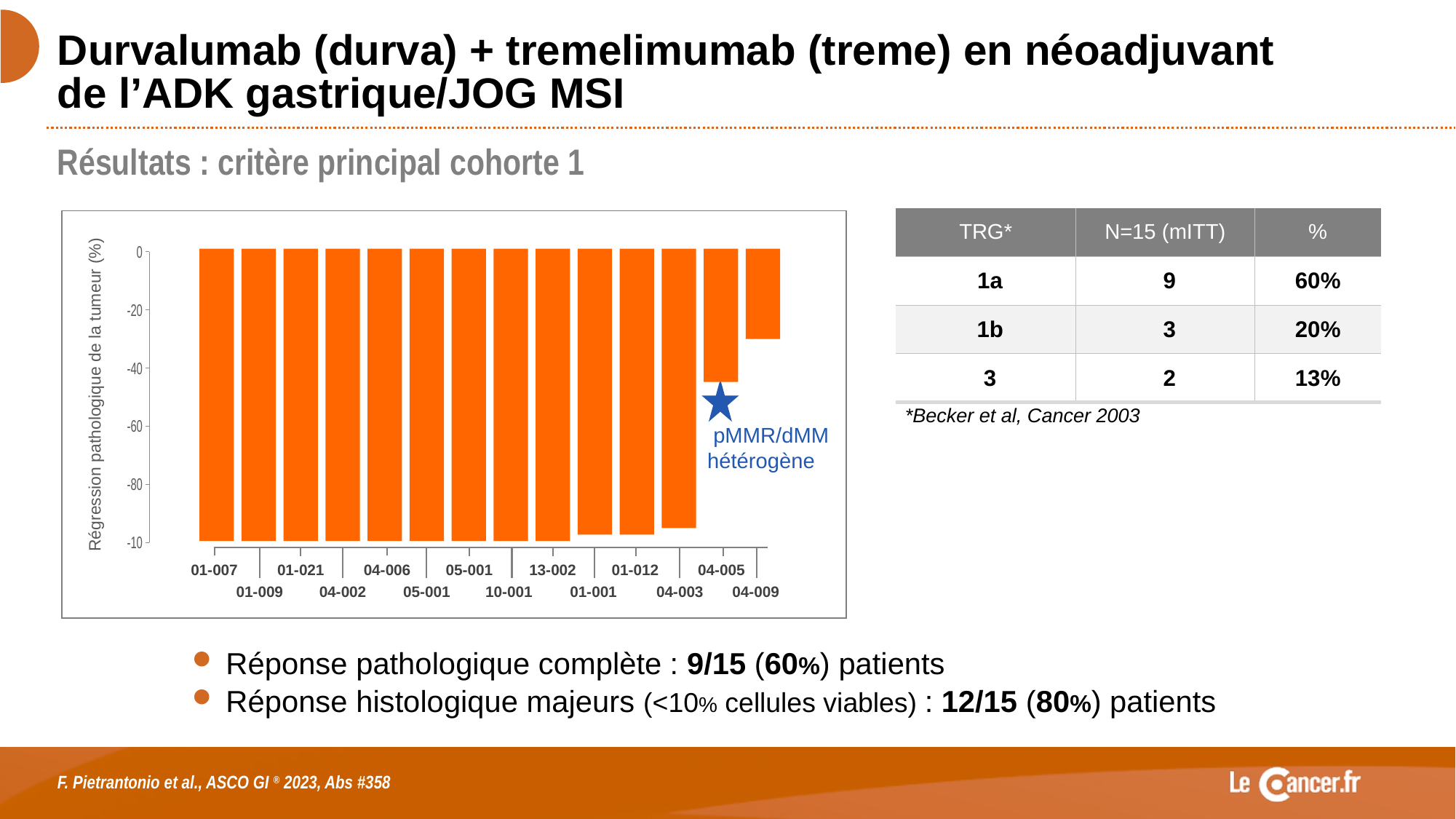
Which patient's bar is marked with a blue star in the chart? 04-005 Is the value for 04-009 greater or less than -40? greater Which has the larger value, 01-007 or 04-009? 04-009 Which has the larger value, 04-005 or 04-009? 04-009 Do the plotted values increase or decrease from left to right along the x axis? increase What kind of chart is shown on the slide? bar chart Is the value for 04-009 greater or less than -20? less What is the label of the y axis of the chart? Régression pathologique de la tumeur (%) How many bars (patients) are plotted in the chart? 14 Which patient has the highest (least negative) value in the chart? 04-009 Is the value for 01-007 greater or less than -80? less